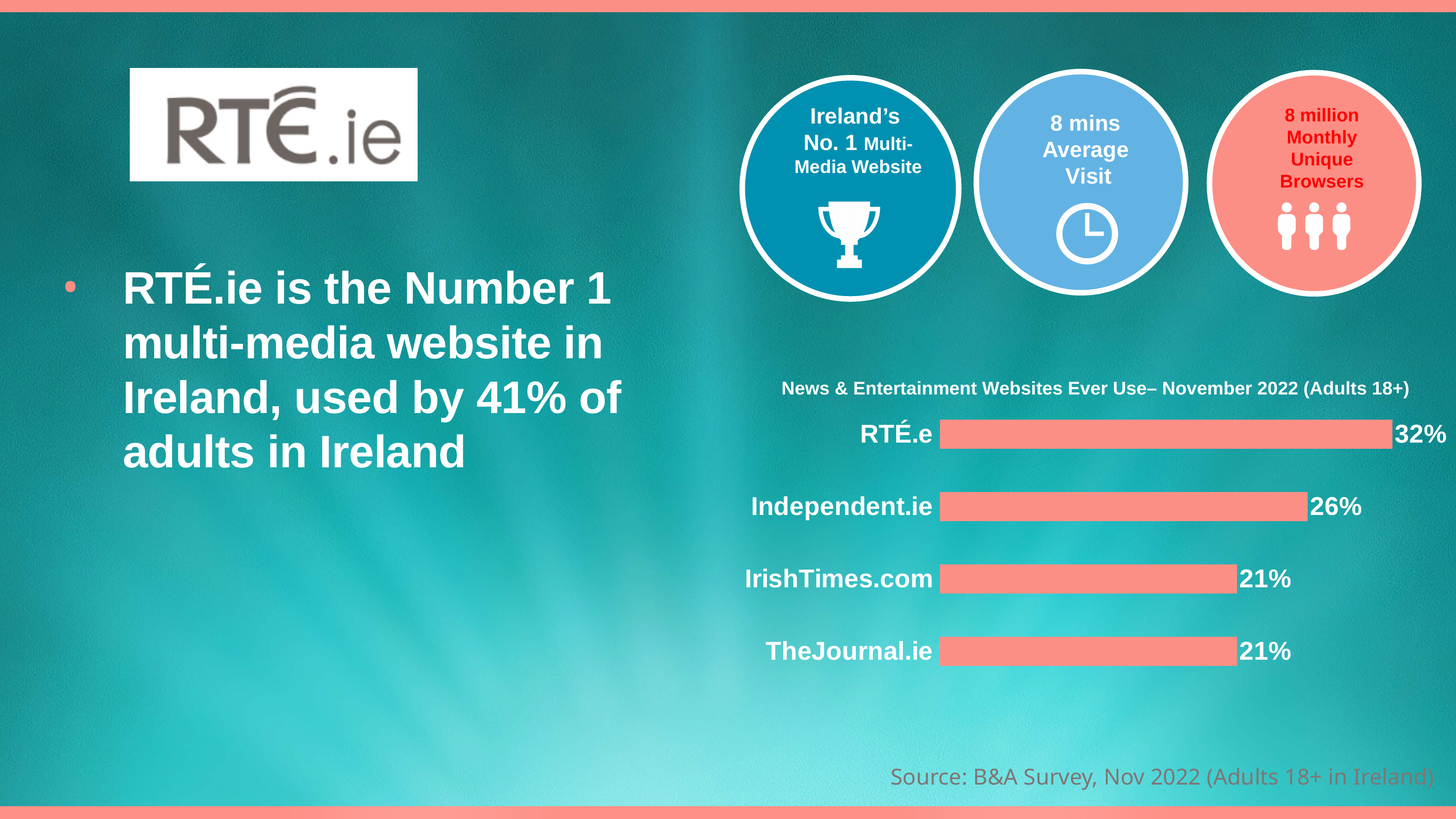
Which is larger, the value for RTÉ.e or the value for IrishTimes.com? RTÉ.e What kind of chart is shown on the slide? Bar chart What is the value for IrishTimes.com in the chart? 21% What is the title of the chart? News & Entertainment Websites Ever Use– November 2022 (Adults 18+) What is the value for RTÉ.e in the chart? 32% Which website has the highest value in the chart? RTÉ.e What is the value for Independent.ie in the chart? 26% How many websites are shown in the chart? 4 What is the difference between the values for RTÉ.e and Independent.ie? 6% What is the value for TheJournal.ie in the chart? 21% What colour are the bars in the chart? Salmon pink What is the difference between the values for Independent.ie and IrishTimes.com? 5%